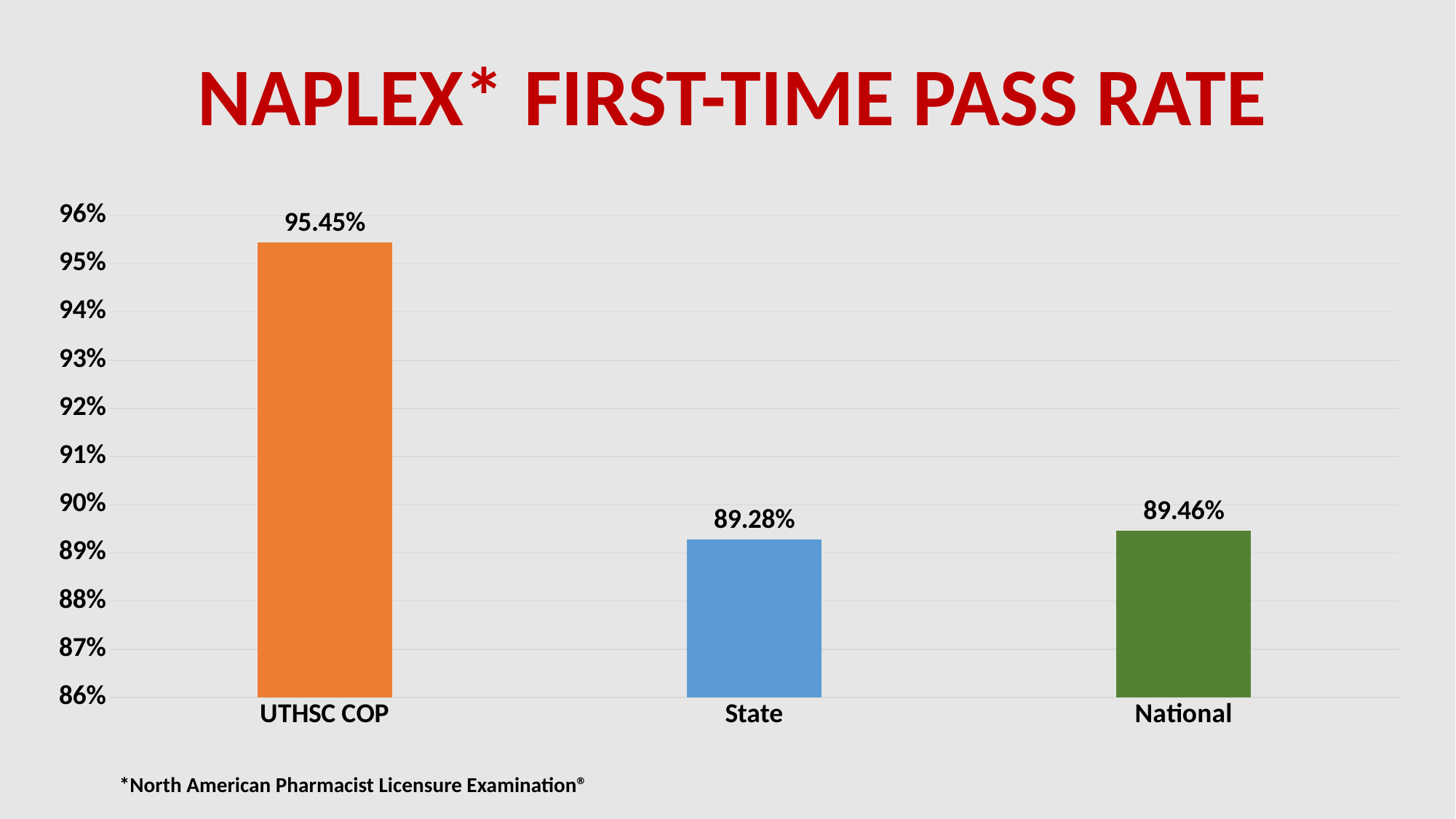
What is the NAPLEX first-time pass rate for UTHSC COP? 95.45% What is the difference between the UTHSC COP pass rate and the State pass rate? 6.17 percentage points What is the title of the chart? NAPLEX* First-Time Pass Rate What is the NAPLEX first-time pass rate for State? 89.28% What is the difference between the UTHSC COP pass rate and the National pass rate? 5.99 percentage points How many categories are shown in the chart? 3 Which category has the highest first-time pass rate? UTHSC COP Is the value for UTHSC COP greater or less than 95%? greater What is the NAPLEX first-time pass rate for National? 89.46% Which has a higher pass rate, State or National? National What kind of chart is shown on the slide? Bar chart Which category has the lowest first-time pass rate? State